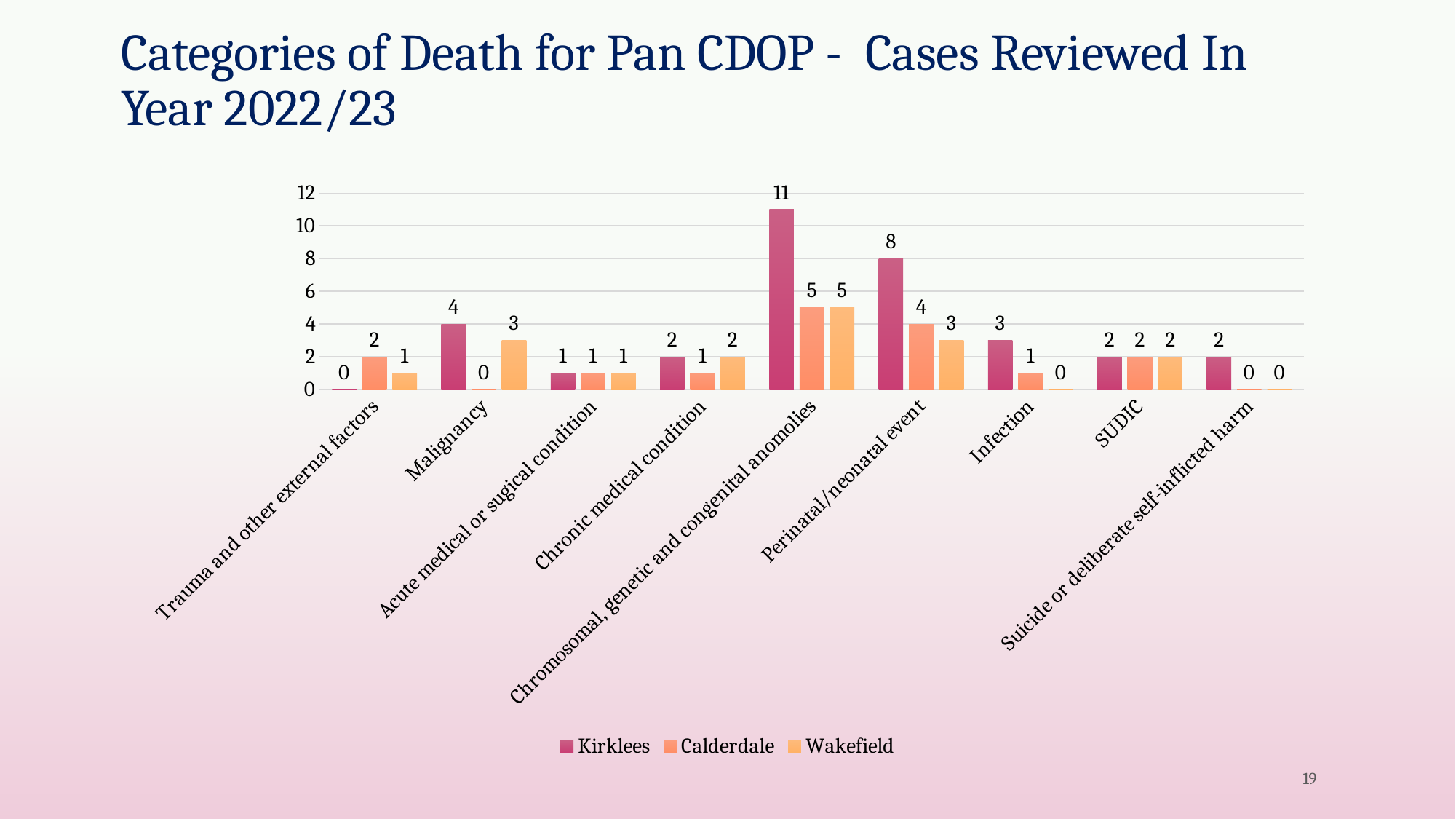
Which category has the highest Kirklees value? Chromosomal, genetic and congenital anomolies What is the difference between the Kirklees and Calderdale values for Perinatal/neonatal event? 4 What is the total of the three series for SUDIC? 6 How many categories are shown on the x axis? 9 What is the Wakefield value for Suicide or deliberate self-inflicted harm? 0 What kind of chart is shown on the slide? Bar chart Which is larger for Infection: the Kirklees value or the Calderdale value? Kirklees What is the Calderdale value for Perinatal/neonatal event? 4 How many series does the legend list? 3 What is the Kirklees value for Chromosomal, genetic and congenital anomolies? 11 Which series is shown in the darkest (magenta) colour in the legend? Kirklees What is the Wakefield value for Malignancy? 3